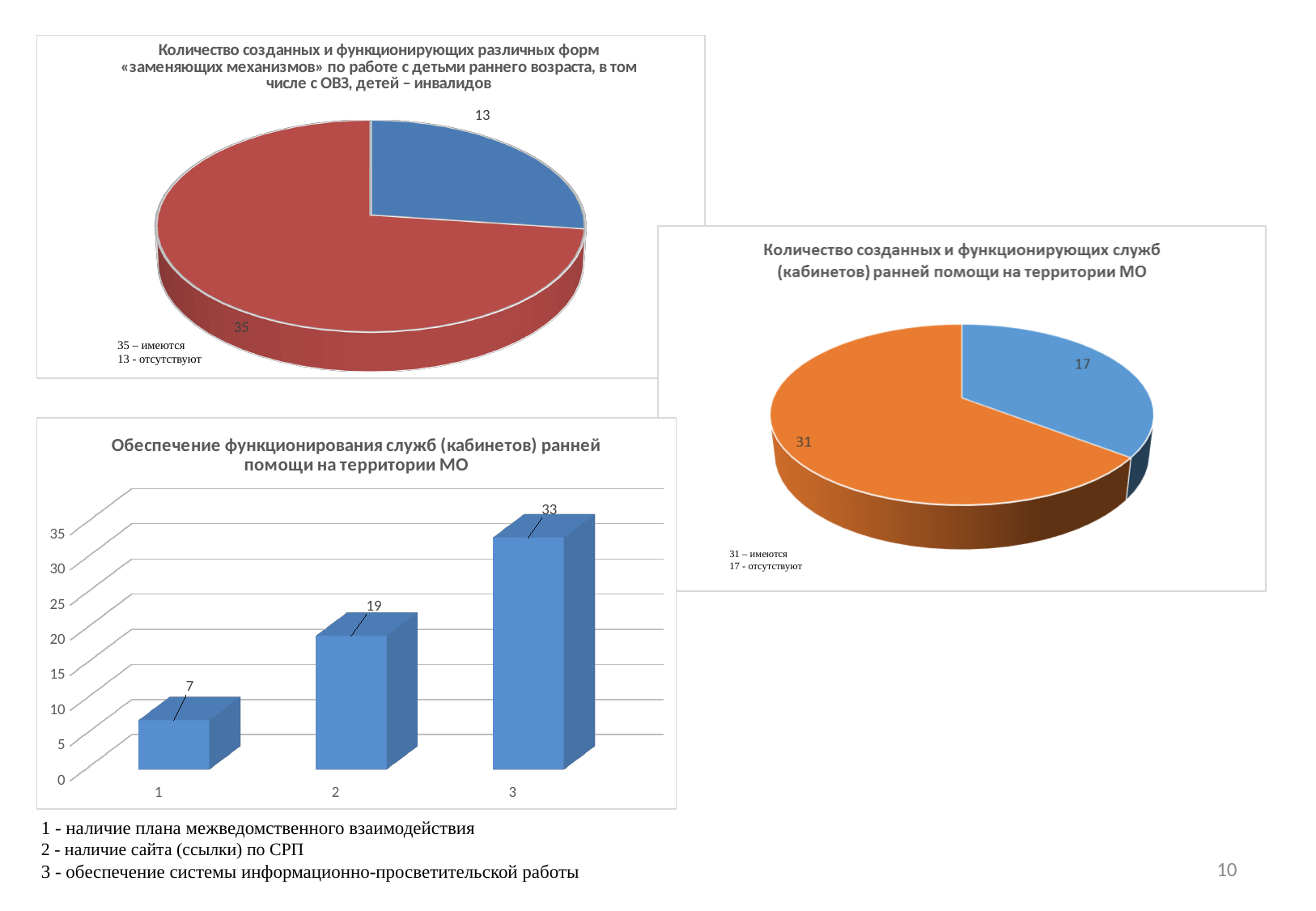
In the top-left pie chart (Количество созданных и функционирующих различных форм «заменяющих механизмов»), what is the value of the red slice? 35 What kind of chart is the bottom-left chart? bar chart In the right pie chart, what is the value of the blue slice? 17 In the top-left pie chart, what is the total of the two slices? 48 In the right pie chart (Количество созданных и функционирующих служб (кабинетов) ранней помощи на территории МО), what is the value of the orange slice? 31 In the right pie chart, what is the difference between the orange slice and the blue slice? 14 In the bottom-left chart, which category has the highest value? 3 In the bottom-left chart, which category has the lowest value? 1 In the top-left pie chart, what is the value of the blue slice? 13 In the bottom-left chart, do the values rise or fall from category 1 to category 3? rise In the bottom-left chart (Обеспечение функционирования служб (кабинетов) ранней помощи на территории МО), what is the value for category 2? 19 In the bottom-left chart, what is the difference between the values for category 3 and category 1? 26